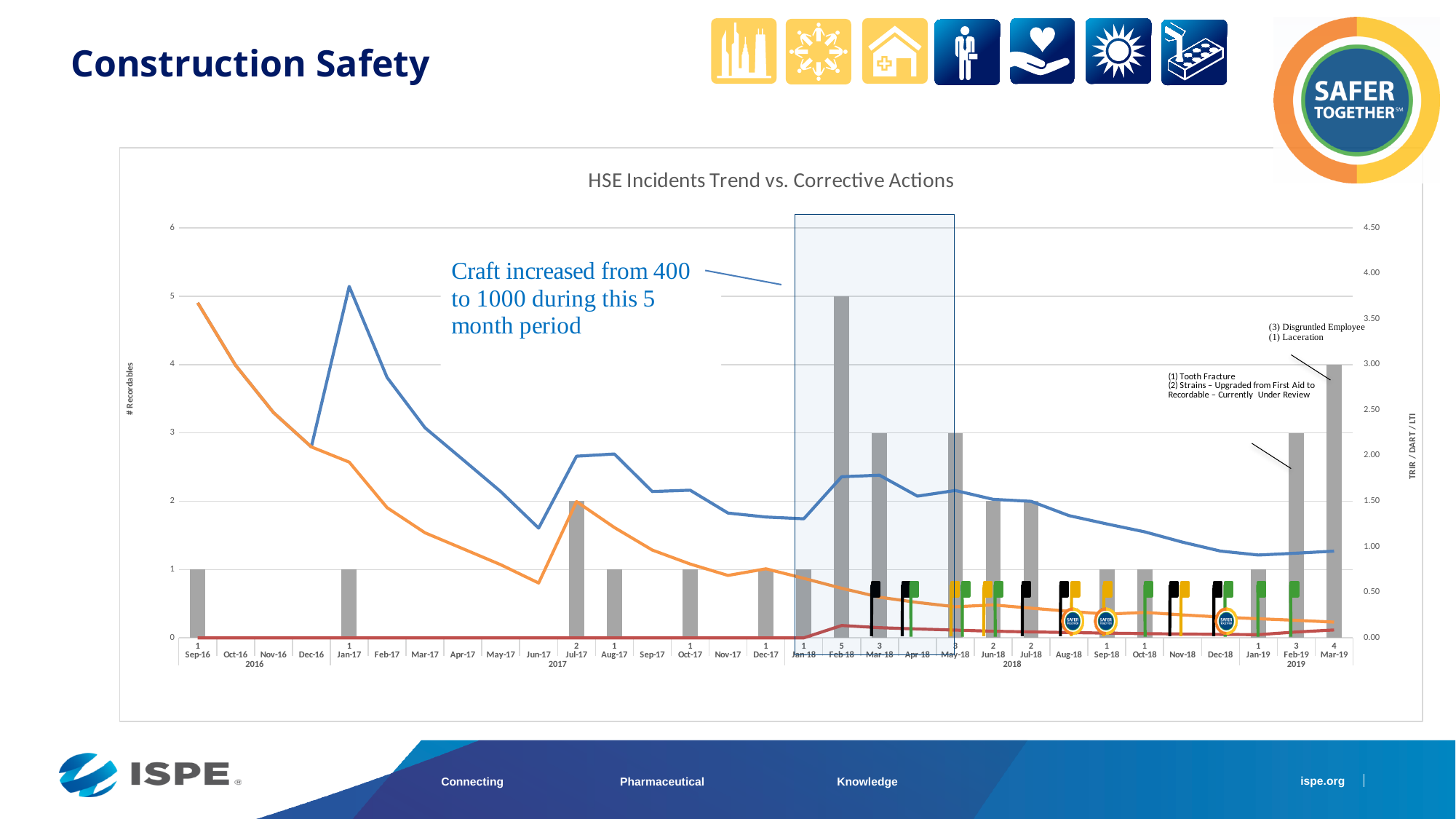
Does the orange line generally rise or fall from Sep-16 to Mar-19? Fall What is the title of the chart? HSE Incidents Trend vs. Corrective Actions What kind of chart is this? Combined bar and line chart What is the number of recordables shown for Feb-18? 5 What is the number of recordables shown for Mar-19? 4 What is the number of recordables shown for Jul-17? 2 Which month has the highest bar for recordables? Feb-18 What is the difference between the recordables in Mar-19 and Jan-19? 3 What is the label of the left vertical axis? # Recordables What is the difference between the recordables in Feb-18 and Mar-19? 1 How many months have a recordables bar plotted on the chart? 17 Which month has more recordables, Feb-19 or Jun-18? Feb-19